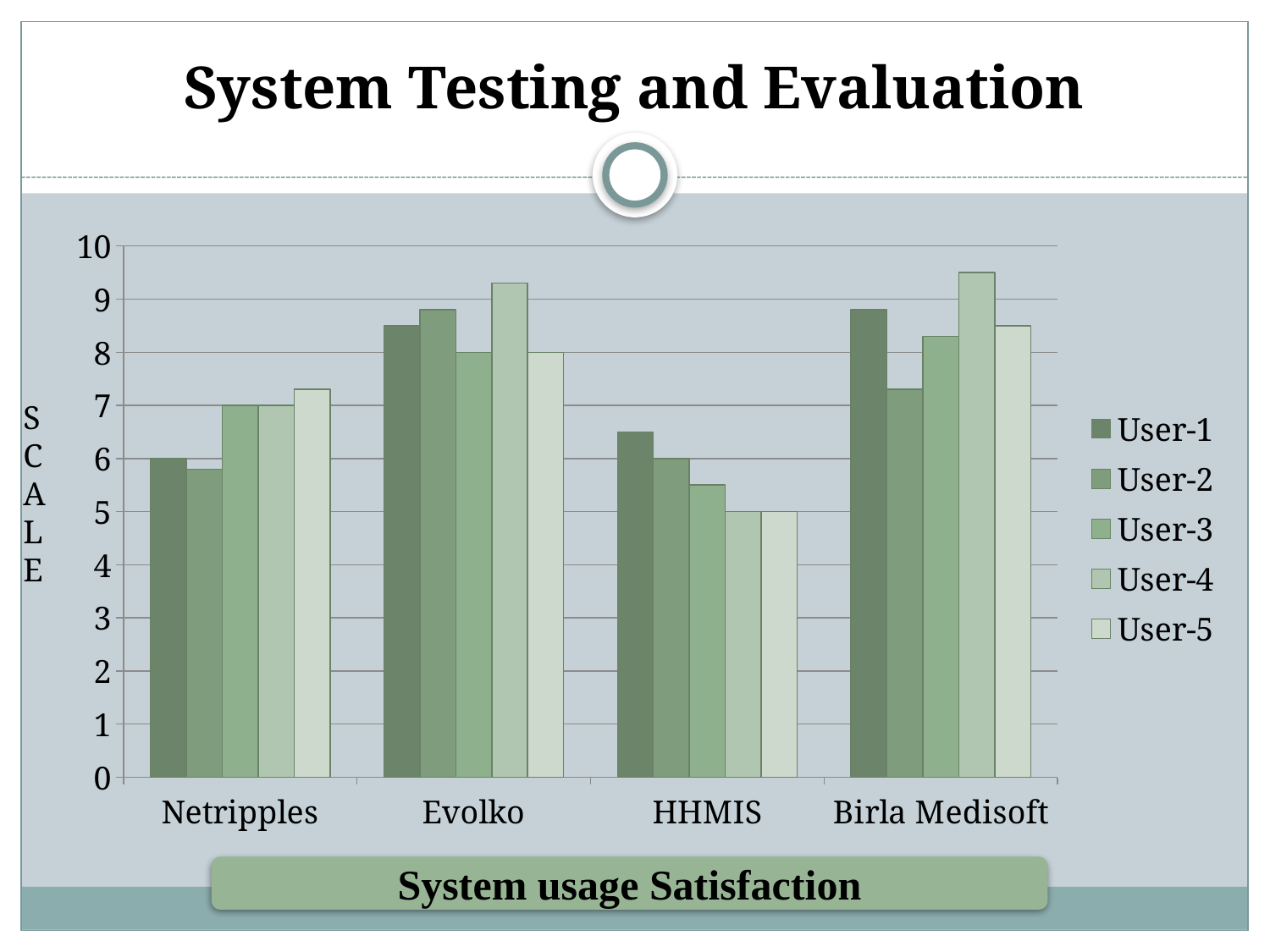
What is the value for User-1 for Netripples? 6 What is the value for User-5 for HHMIS? 5 Which is larger, the User-1 value for Evolko or the User-1 value for HHMIS? Evolko What is the label shown below the x axis of the chart? System usage Satisfaction Which user gave the highest rating for Birla Medisoft? User-4 How many series does the legend list? 5 What is the value for User-3 for Evolko? 8 What kind of chart is shown on the slide? bar chart Is the value for User-1 for HHMIS greater or less than 6? greater How many systems (categories) are shown on the x axis? 4 Is the value for User-4 for Evolko greater or less than 9? greater Which user gave the lowest rating for Birla Medisoft? User-2